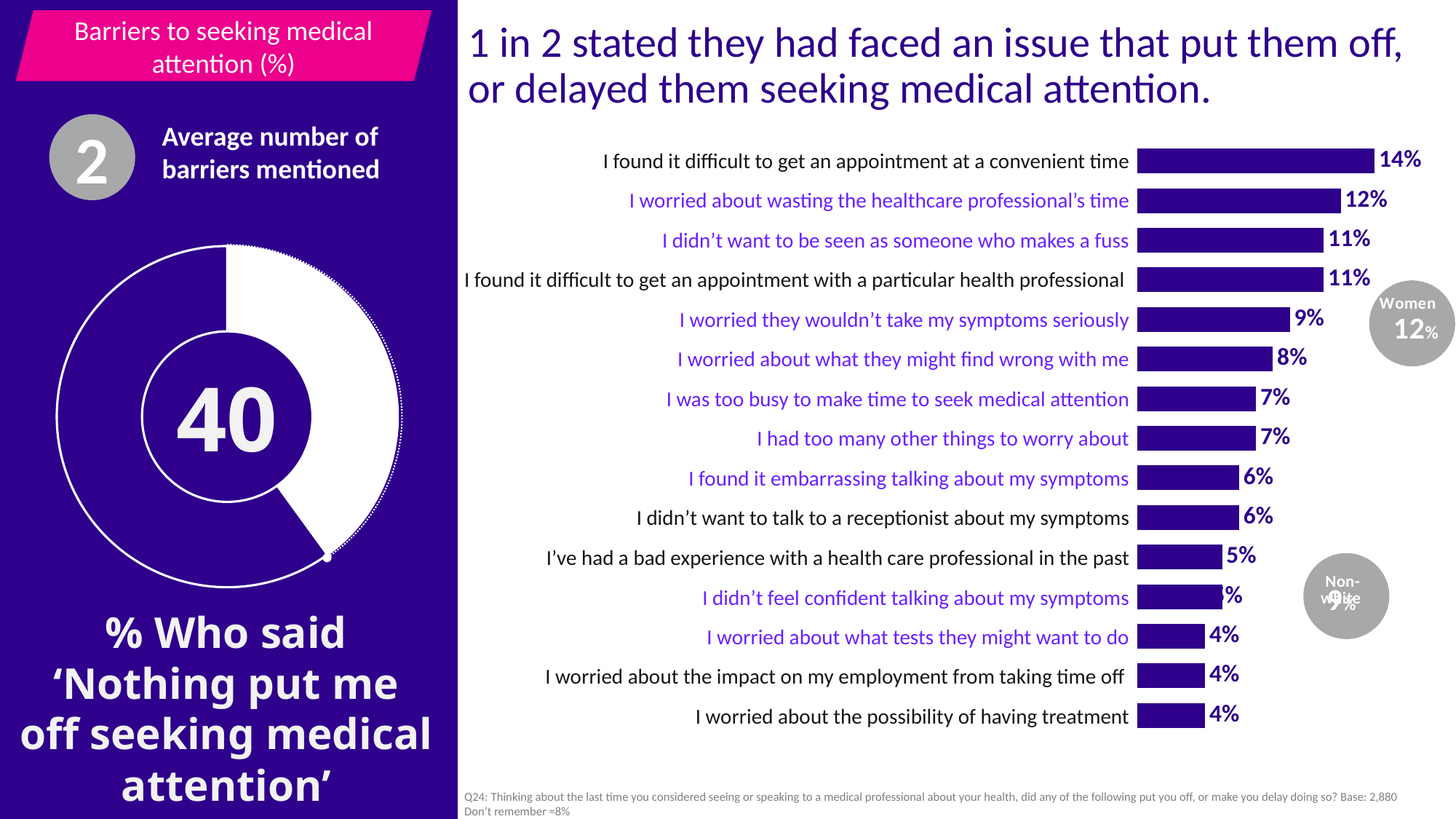
How many barriers are listed in the bar chart? 15 In the bar chart, what percentage worried they wouldn't take their symptoms seriously? 9% In the bar chart, do the values increase or decrease going from the top bar to the bottom bar? Decrease In the bar chart, which is larger: 'I was too busy to make time to seek medical attention' or 'I found it embarrassing talking about my symptoms'? I was too busy to make time to seek medical attention In the bar chart, what percentage worried about what they might find wrong with them? 8% In the bar chart, which barrier has the highest percentage? I found it difficult to get an appointment at a convenient time In the bar chart, what percentage had a bad experience with a health care professional in the past? 5% In the bar chart, what percentage worried about wasting the healthcare professional's time? 12% In the donut chart on the left, what percentage said 'Nothing put me off seeking medical attention'? 40 What kind of chart is used to show the barriers to seeking medical attention? Bar chart In the bar chart, what percentage found it difficult to get an appointment at a convenient time? 14% In the bar chart, what is the difference between 'I found it difficult to get an appointment at a convenient time' and 'I worried about wasting the healthcare professional's time'? 2 percentage points